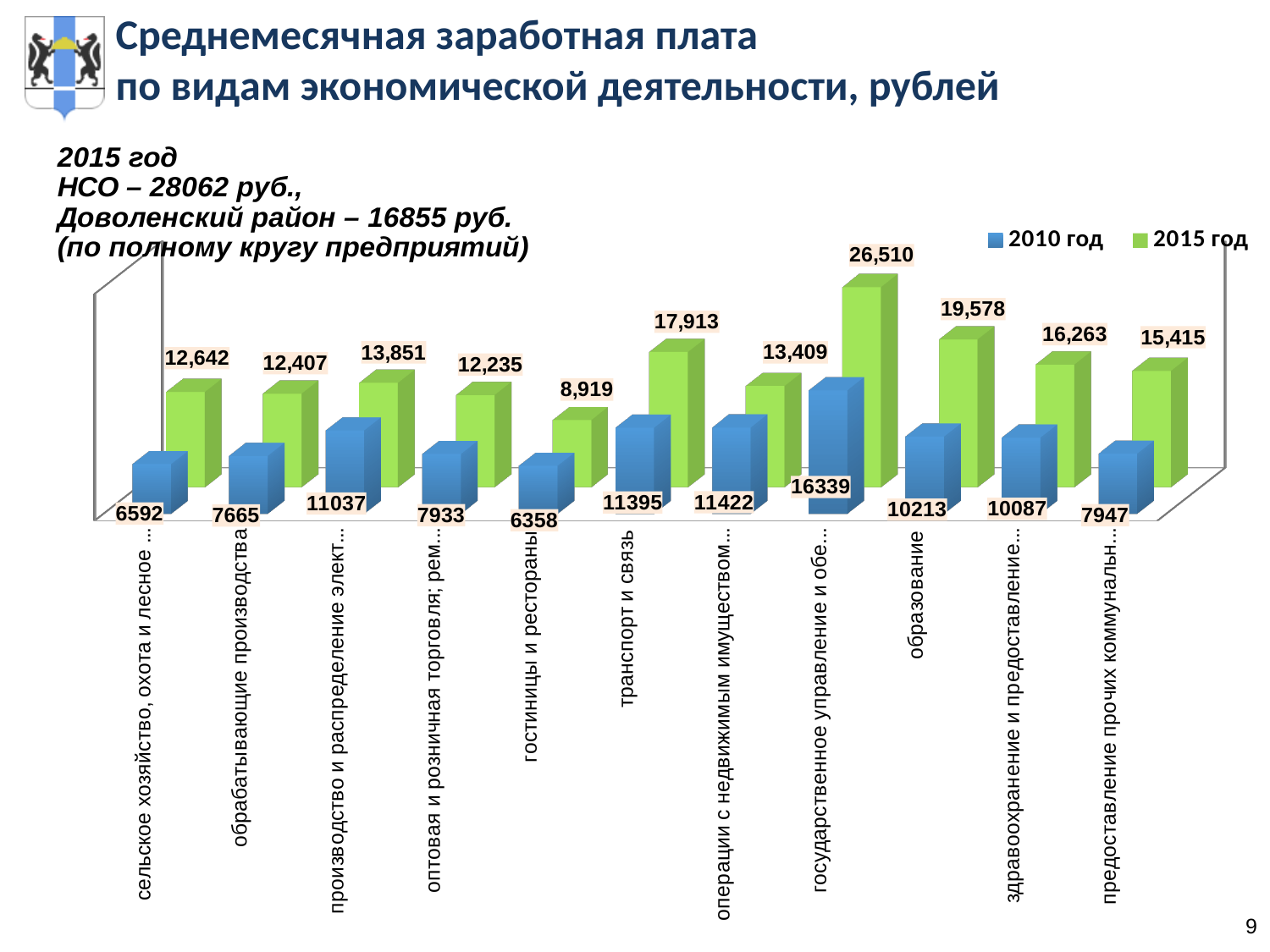
Which category has the lowest 2015 год value? гостиницы и рестораны What is the difference between the 2015 год and 2010 год values for образование? 9365 What is the 2015 год value for образование? 19,578 How many categories are shown on the chart? 11 What is the difference between the 2015 год and 2010 год values for транспорт и связь? 6518 What is the 2010 год value for транспорт и связь? 11395 Which has the larger 2010 год value: образование or транспорт и связь? транспорт и связь Which category has the lowest 2010 год value? гостиницы и рестораны What is the 2010 год value for обрабатывающие производства? 7665 How many series does the legend list? 2 What is the 2015 год value for гостиницы и рестораны? 8,919 Which has the larger 2015 год value: образование or транспорт и связь? образование